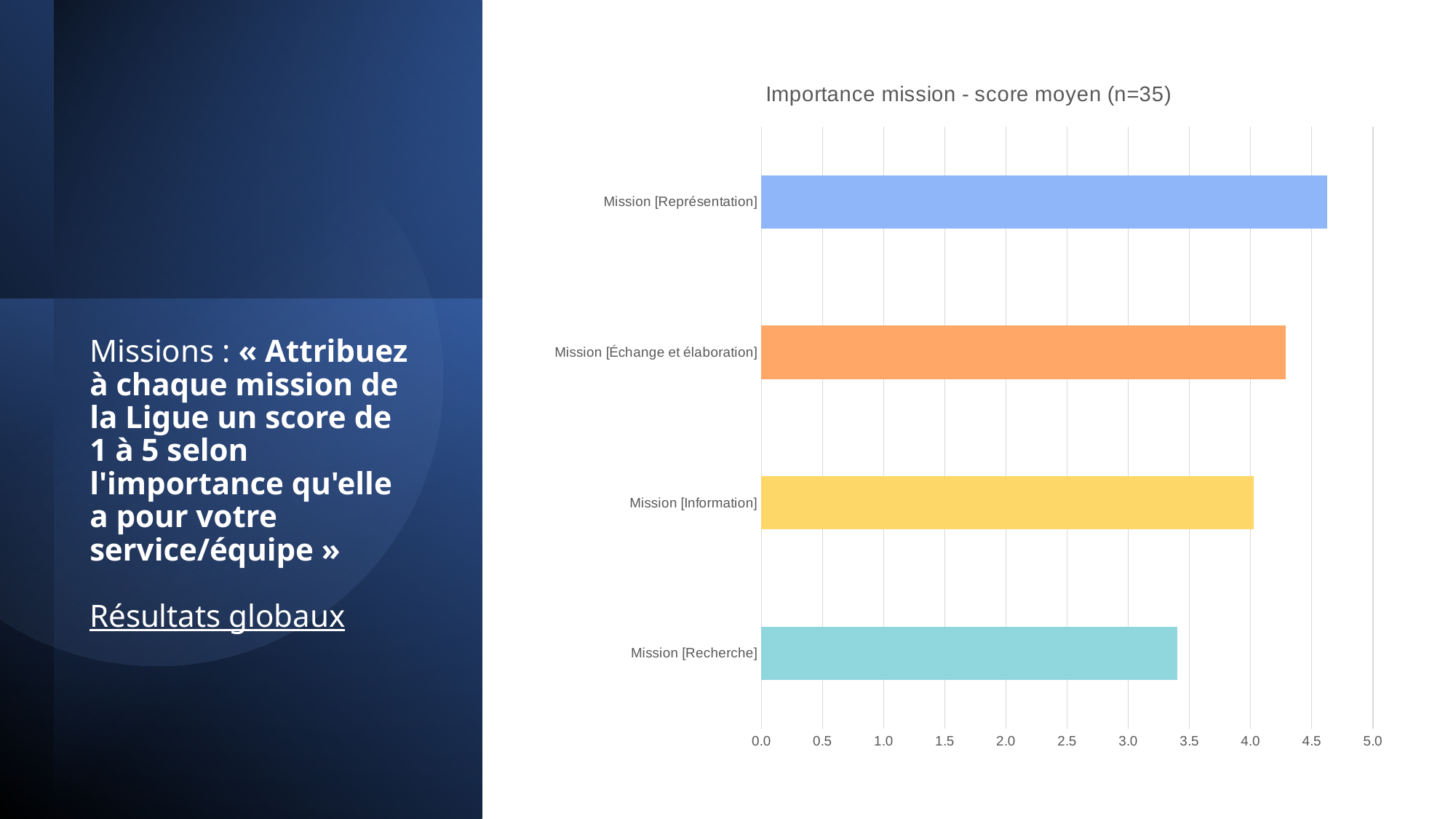
What is the maximum value shown on the horizontal axis of the chart? 5.0 What type of chart is shown on the slide? Bar chart Is the value for Mission [Recherche] greater or less than 3.0? greater Which has a higher score: Mission [Échange et élaboration] or Mission [Information]? Mission [Échange et élaboration] Is the value for Mission [Échange et élaboration] greater or less than 4.0? greater How many missions (categories) are plotted in the chart? 4 What is the title of the chart? Importance mission - score moyen (n=35) Is the value for Mission [Représentation] greater or less than 4.0? greater Which mission has the lowest average importance score? Mission [Recherche] Which has a lower score: Mission [Représentation] or Mission [Recherche]? Mission [Recherche] Which mission has the highest average importance score? Mission [Représentation]